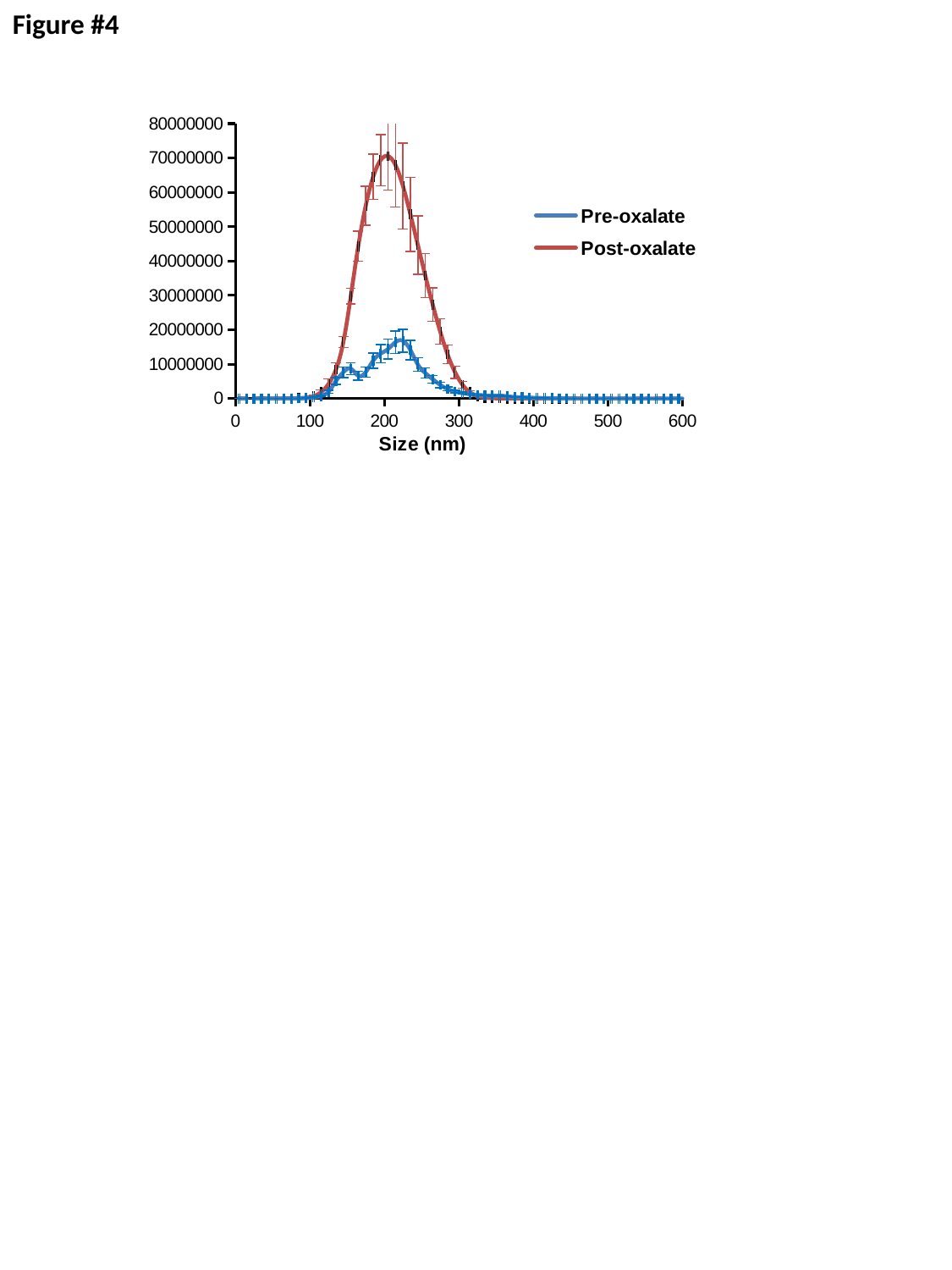
Do the Post-oxalate values rise or fall as size increases from 100 nm to 200 nm? rise What is the highest value shown on the y axis? 80000000 Do the Post-oxalate values rise or fall as size increases from 200 nm to 300 nm? fall What kind of chart is shown on the slide? Line chart What are the two series named in the legend? Pre-oxalate and Post-oxalate What is the title of the x axis? Size (nm) Which series has the lowest peak value? Pre-oxalate Is the Post-oxalate value at 400 nm greater or less than 10000000? less Which series reaches the higher peak value, Pre-oxalate or Post-oxalate? Post-oxalate Is the peak value of the Pre-oxalate series greater or less than 20000000? less Is the peak value of the Post-oxalate series greater or less than 60000000? greater How many series does the legend list? 2